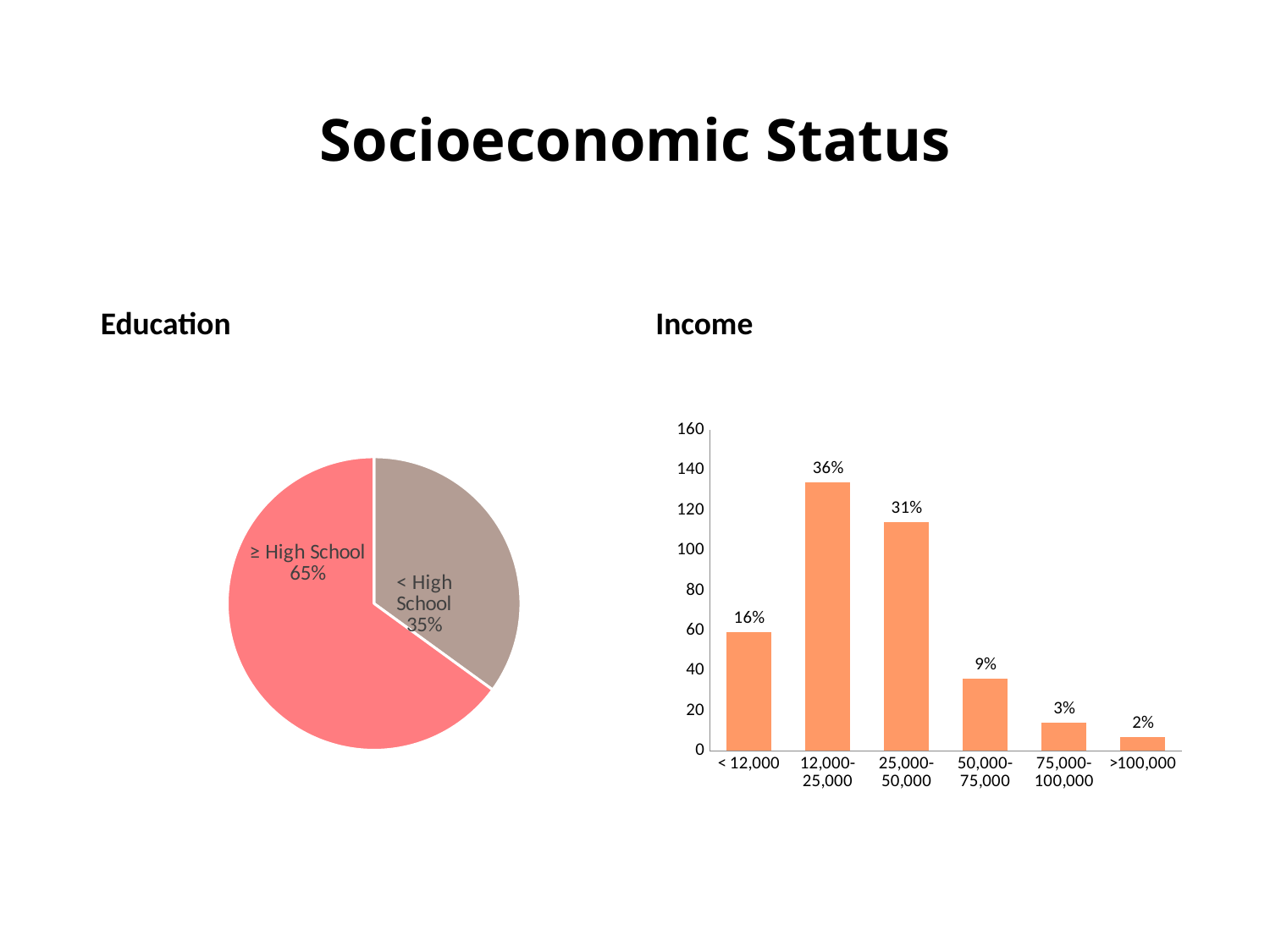
What kind of chart is the Income chart? bar chart In the Income chart, which income category has the highest bar? 12,000-25,000 In the Income chart, what is the data label on the 12,000-25,000 bar? 36% In the Income chart, is the bar for 25,000-50,000 greater or less than 120 on the y axis? less In the Income chart, which income category has the lowest bar? >100,000 In the Income chart, which bar is taller: 25,000-50,000 or 50,000-75,000? 25,000-50,000 In the Income chart, is the bar for < 12,000 greater or less than 40 on the y axis? greater In the Income chart, how many income categories are shown on the x axis? 6 In the Income chart, what is the data label on the 50,000-75,000 bar? 9% What kind of chart is the Education chart? pie chart In the Education chart, what share of the pie is labelled "< High School"? 35% In the Education chart, what share of the pie is labelled "≥ High School"? 65%